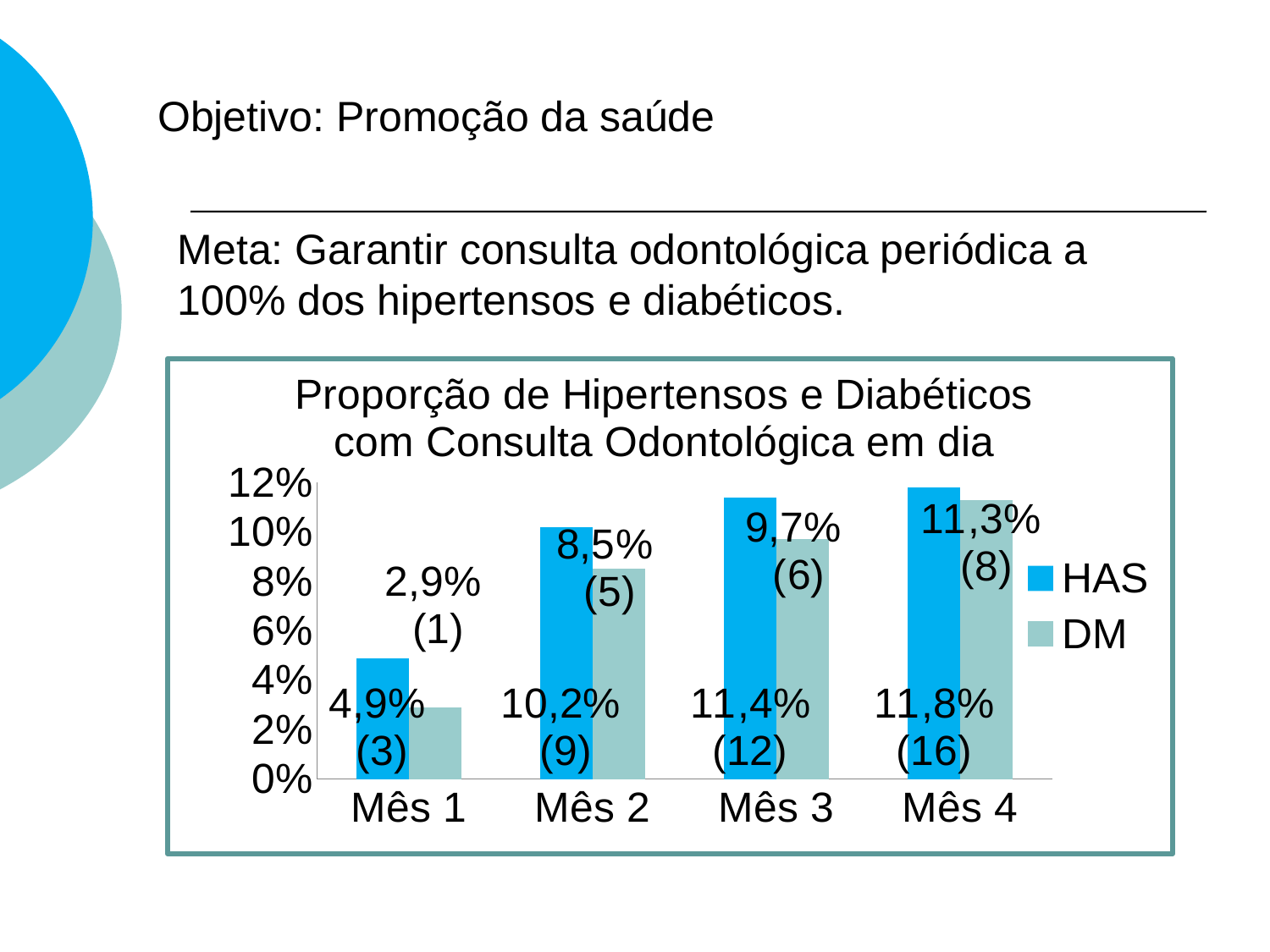
What is the DM value for Mês 3? 9,7% Do the HAS values rise or fall from Mês 1 to Mês 4? Rise What type of chart is shown on the slide? Bar chart What is the DM value for Mês 2? 8,5% Which month has the lowest DM value? Mês 1 Which month has the highest HAS value? Mês 4 What is the HAS value for Mês 4? 11,8% What is the difference between the HAS and DM values for Mês 1? 2,0% How many series does the legend list? 2 What is the HAS value for Mês 1? 4,9% How many months are shown on the x axis? 4 Which is larger for Mês 2, the HAS value or the DM value? HAS